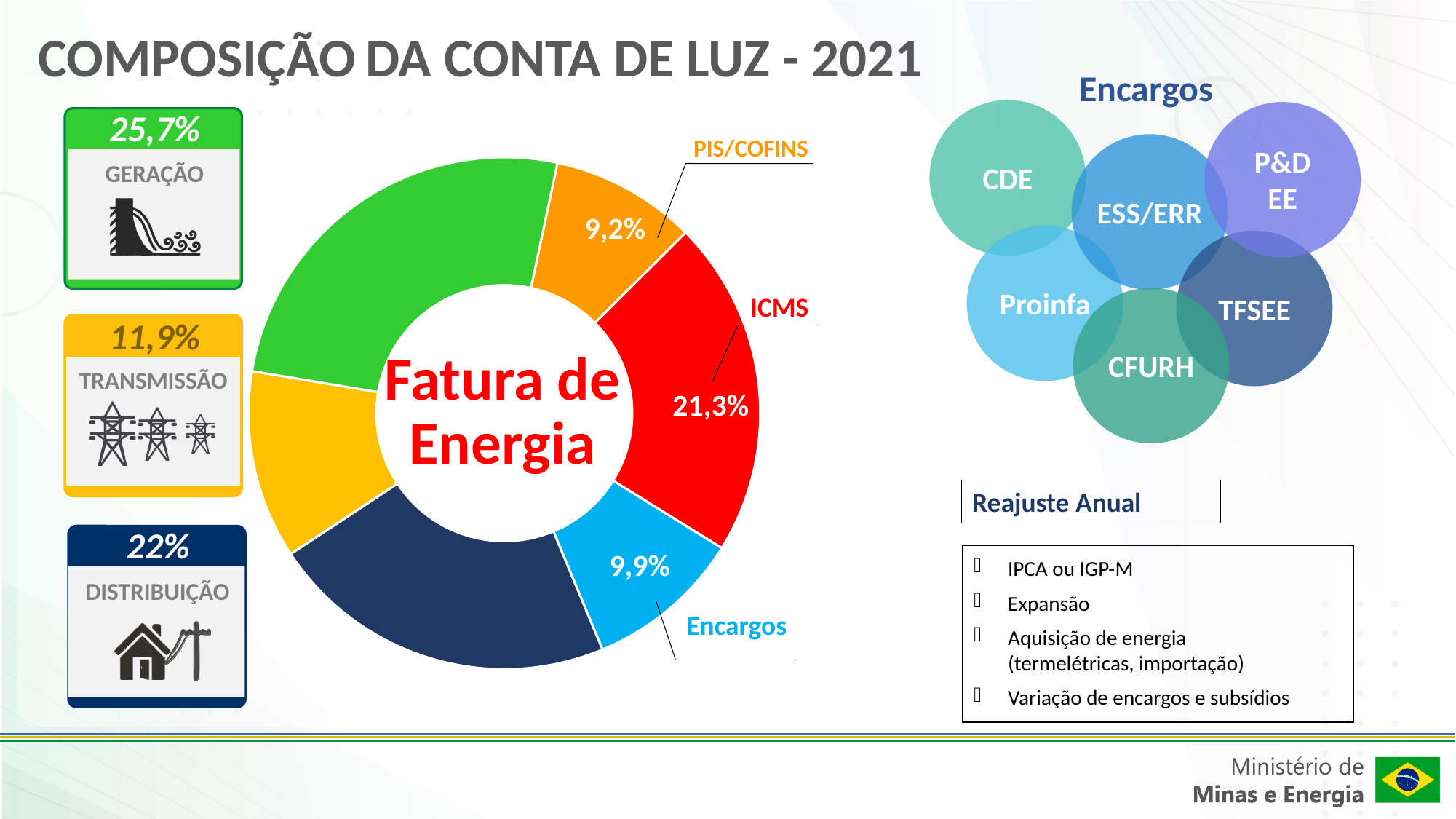
Which component has the smallest share of the energy bill? PIS/COFINS Which component has the largest share of the energy bill? Geração What percentage does Geração account for according to the slide? 25,7% What text appears in the centre of the donut chart? Fatura de Energia What percentage is shown for Distribuição? 22% What type of chart is used to show the composition of the energy bill? Pie (donut) chart What percentage of the energy bill does ICMS represent in the donut chart? 21,3% What is the difference in percentage points between Distribuição and Transmissão? 10,1 Which is larger, the share for ICMS or the share for Distribuição? Distribuição How many slices does the donut chart have? 6 What percentage is labelled for Encargos in the chart? 9,9% What share is shown for PIS/COFINS in the chart? 9,2%